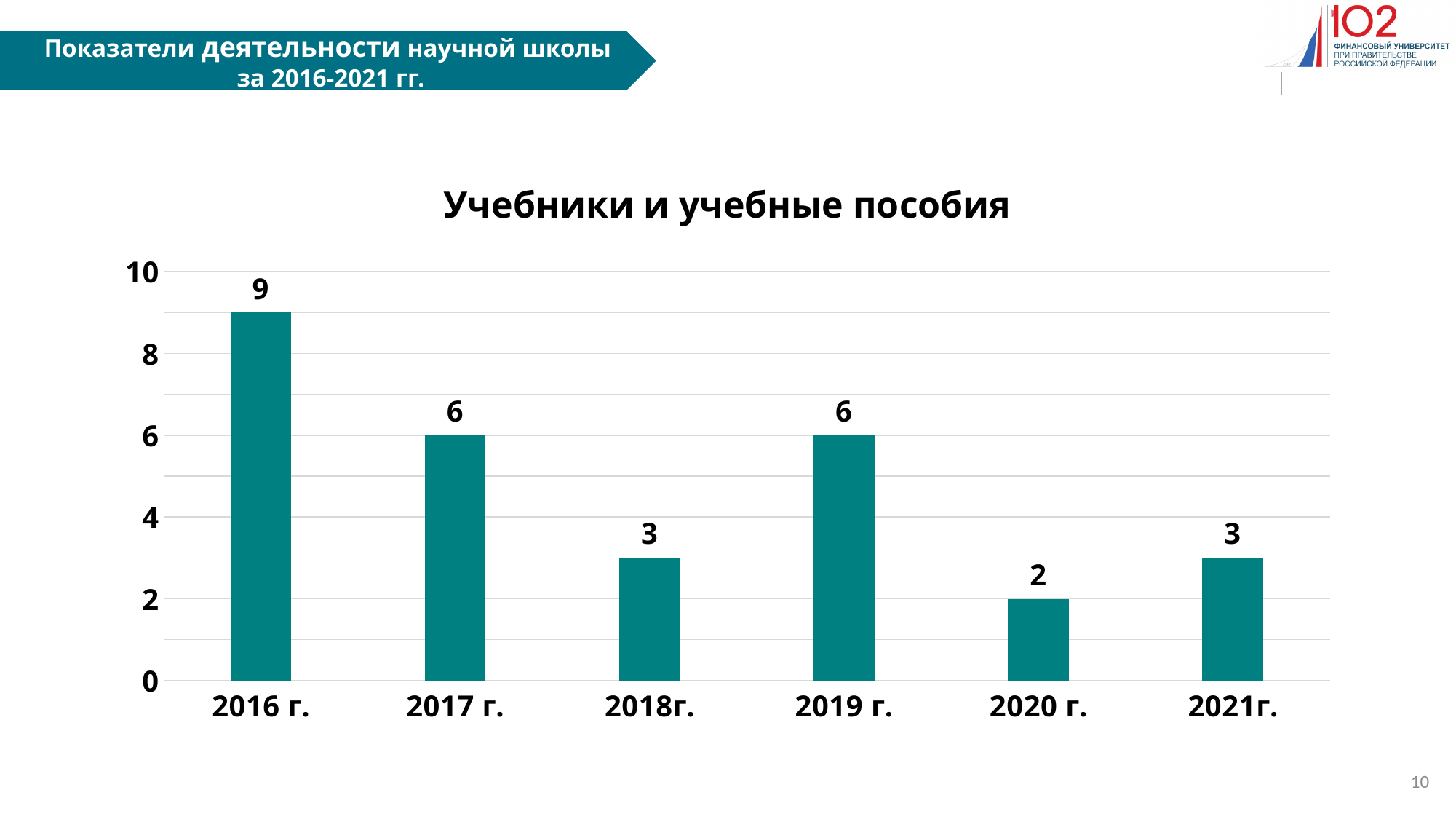
What is the difference between the values for 2019 г. and 2020 г.? 4 Which is larger, the value for 2018г. or the value for 2019 г.? 2019 г. Is the value for 2016 г. greater or less than 8? greater Which year has the highest value? 2016 г. What is the value for 2016 г.? 9 Which year has the lowest value? 2020 г. What kind of chart is shown on the slide? bar chart How many years are shown on the x axis? 6 What is the value for 2020 г.? 2 What is the difference between the values for 2016 г. and 2017 г.? 3 What is the title of the chart? Учебники и учебные пособия What is the value for 2019 г.? 6